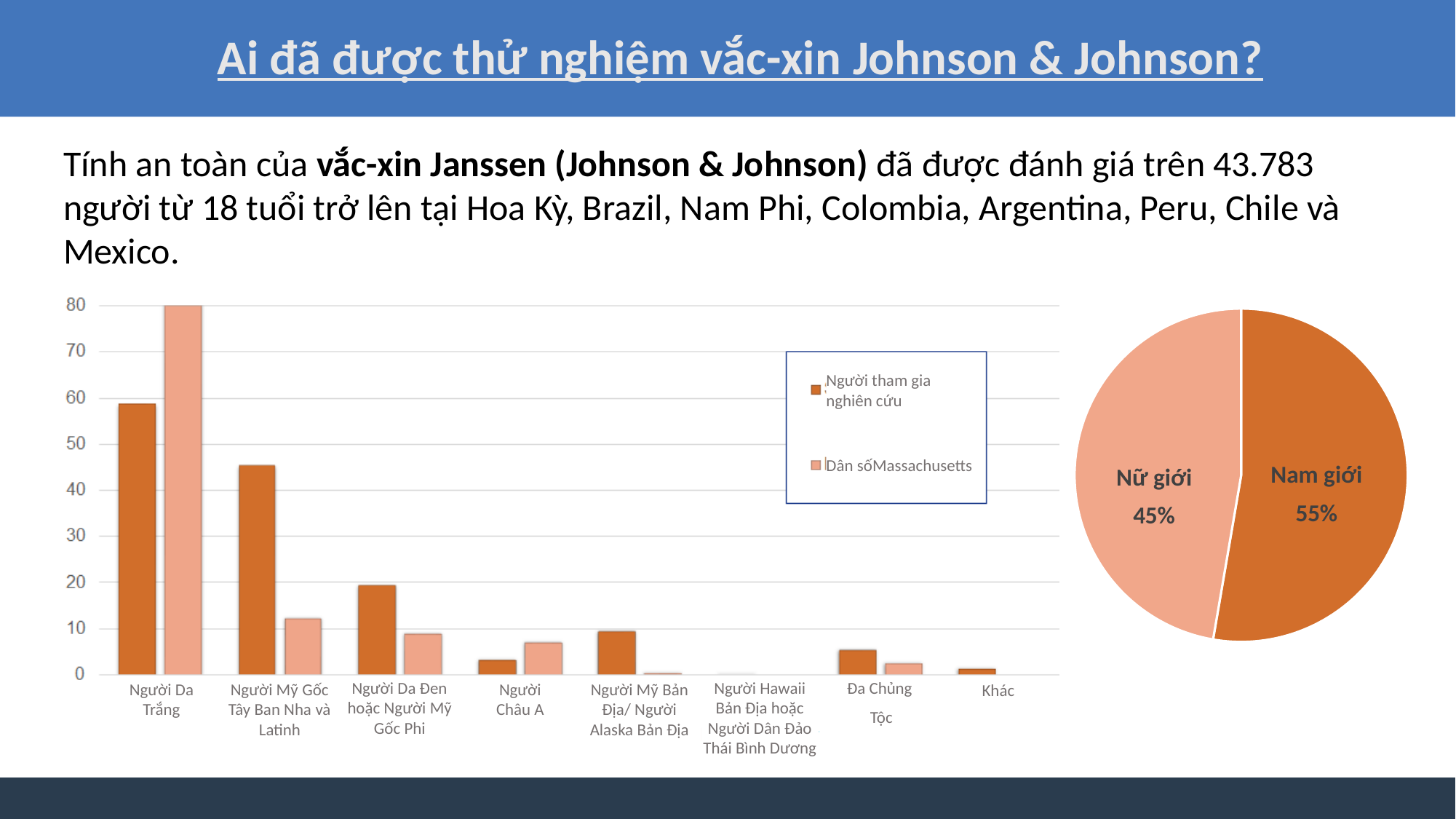
On the bar chart on the left, how many categories are shown on the x axis? 8 What kind of chart is the chart on the left of the slide? Bar chart On the pie chart on the right, which slice is larger, Nam giới or Nữ giới? Nam giới On the pie chart on the right, how many slices are there? 2 On the pie chart on the right, what is the difference in percentage points between the Nam giới and Nữ giới slices? 10 percentage points On the pie chart on the right, what share is labelled for Nữ giới? 45% On the bar chart on the left, is the Người tham gia nghiên cứu value for Người Da Trắng greater or less than 50? greater On the bar chart on the left, which category has the highest value for the Người tham gia nghiên cứu series? Người Da Trắng On the bar chart on the left, how many series does the legend list? 2 On the bar chart on the left, for Người Mỹ Gốc Tây Ban Nha và Latinh, which series has the larger value, Người tham gia nghiên cứu or Dân số Massachusetts? Người tham gia nghiên cứu On the pie chart on the right, what share is labelled for Nam giới? 55% On the bar chart on the left, is the Người tham gia nghiên cứu value for Người Châu Á greater or less than 10? less